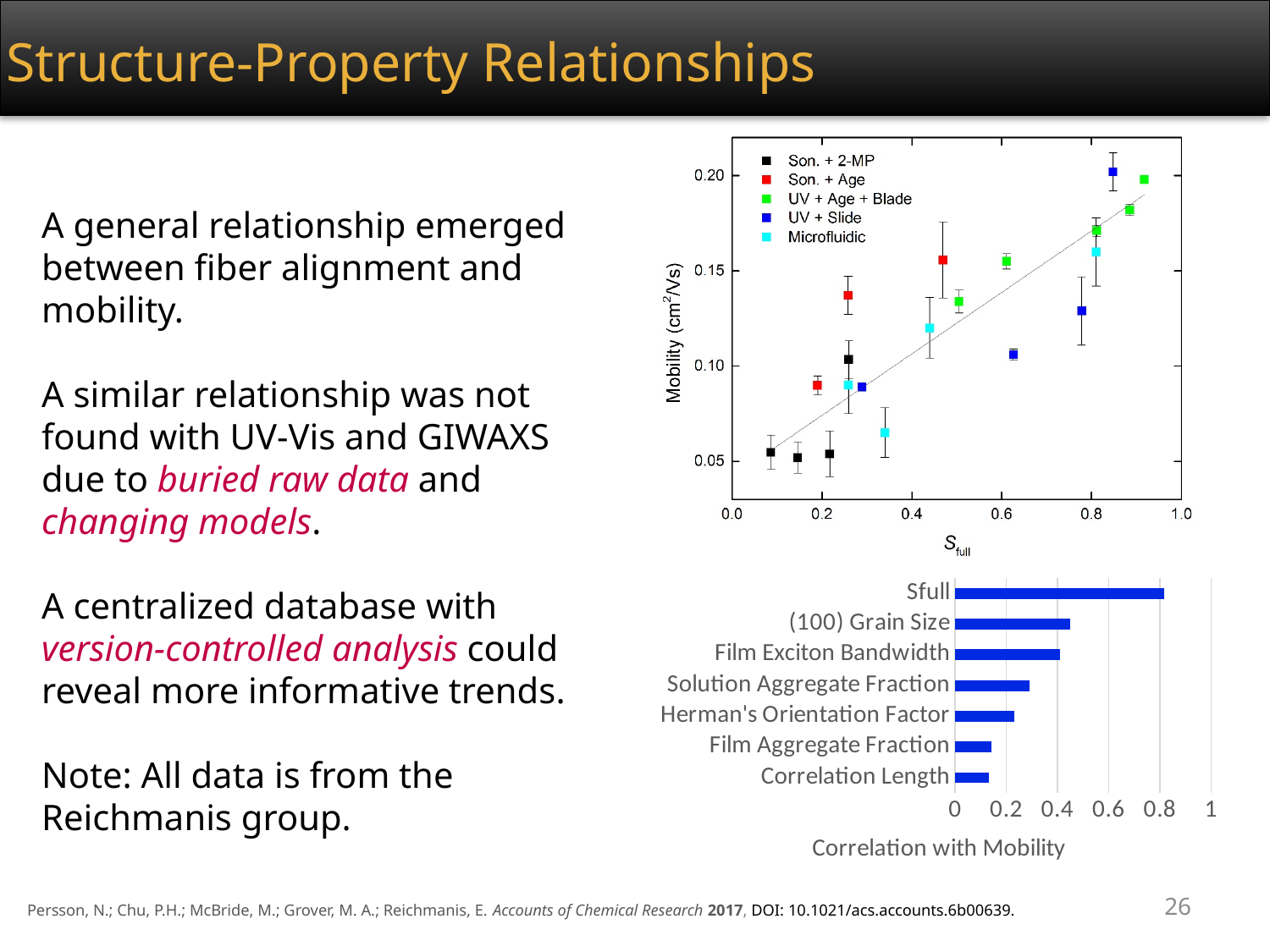
In the top-right scatter plot, what is the label of the y axis? Mobility (cm²/Vs) In the bottom-right bar chart (Correlation with Mobility), which is larger: Solution Aggregate Fraction or Film Aggregate Fraction? Solution Aggregate Fraction In the bottom-right bar chart (Correlation with Mobility), which is larger: Film Exciton Bandwidth or Herman's Orientation Factor? Film Exciton Bandwidth In the bottom-right bar chart (Correlation with Mobility), is the value for Herman's Orientation Factor greater or less than 0.4? less What kind of chart is the bottom-right chart labelled Correlation with Mobility? Bar chart In the top-right scatter plot of Mobility versus Sfull, does mobility generally rise or fall as Sfull increases? rise In the bottom-right bar chart (Correlation with Mobility), how many categories are shown? 7 In the bottom-right bar chart (Correlation with Mobility), which category has the lowest correlation? Correlation Length In the bottom-right bar chart (Correlation with Mobility), which category has the highest correlation? Sfull In the top-right scatter plot of Mobility versus Sfull, how many series does the legend list? 5 In the bottom-right bar chart (Correlation with Mobility), is the value for (100) Grain Size greater or less than 0.4? greater